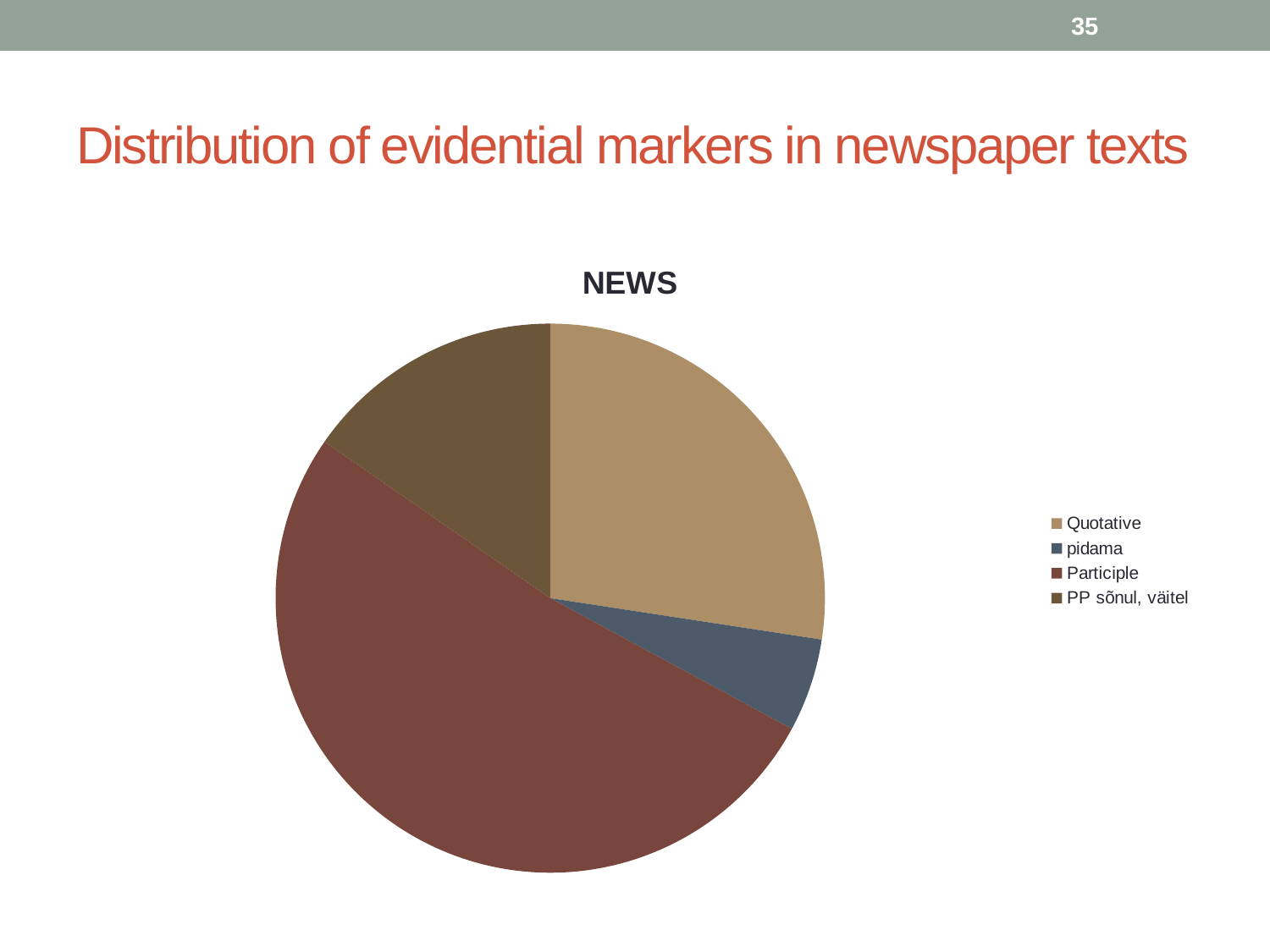
Which slice is larger, Participle or PP sõnul, väitel? Participle How many categories does the pie chart have? 4 Which category is listed first in the legend? Quotative Which category has the smallest slice of the pie? pidama What kind of chart is shown on the slide? pie chart Which slice is larger, Quotative or PP sõnul, väitel? Quotative What is the title of the chart? NEWS Which slice is larger, pidama or PP sõnul, väitel? PP sõnul, väitel Which category has the largest slice of the pie? Participle